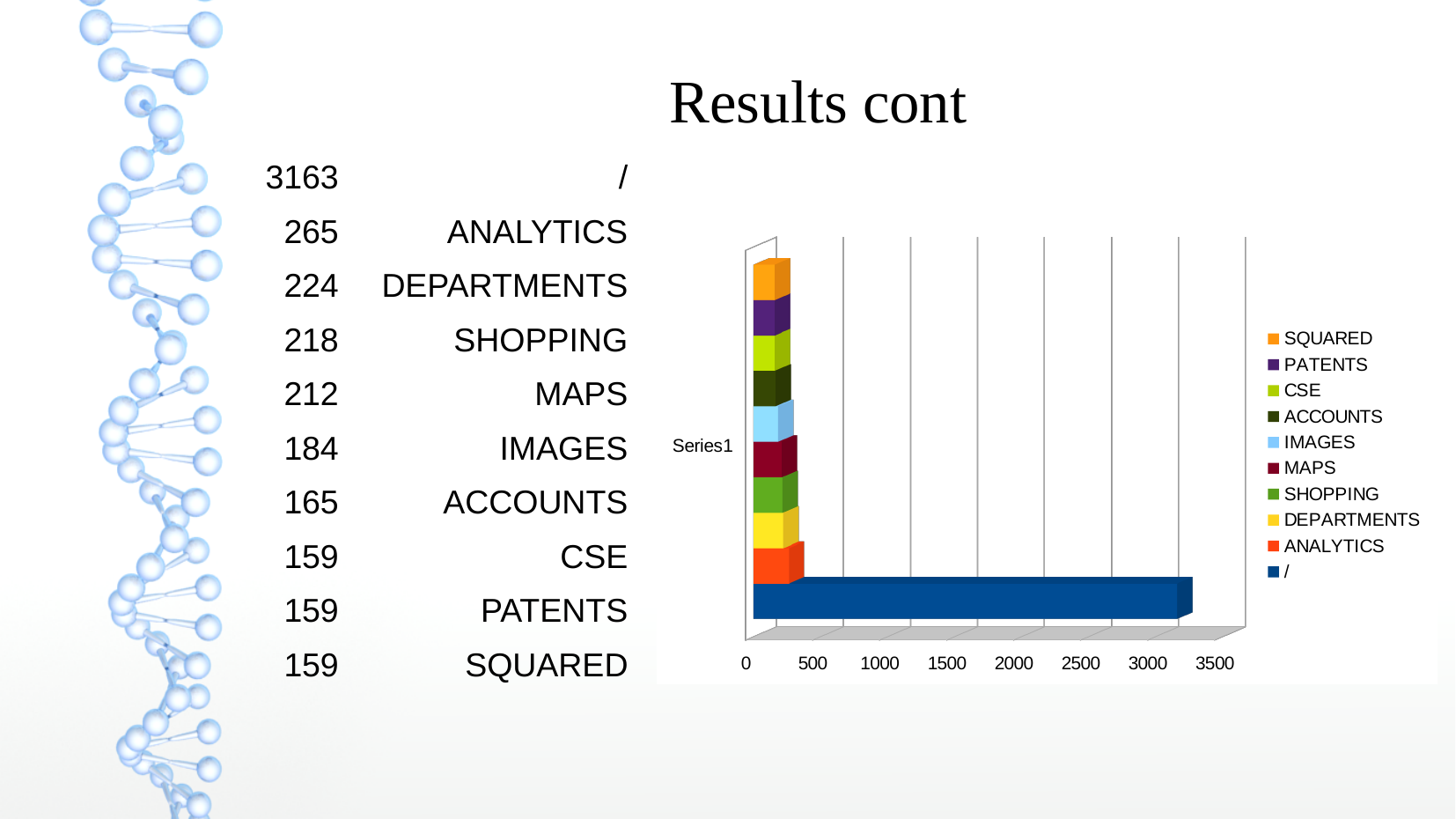
Is the value for the ANALYTICS series greater or less than 500? less According to the values listed on the slide, what is the value for ANALYTICS? 265 What kind of chart is shown on the slide? bar chart What is the category label shown on the vertical axis of the chart? Series1 Is the value for the "/" series greater or less than 3000? greater Which series has the longest bar in the chart? / According to the values listed on the slide, what is the value for the "/" series? 3163 Which is larger, the value for DEPARTMENTS or the value for ACCOUNTS? DEPARTMENTS Using the values listed on the slide, what is the difference between the "/" value and the ANALYTICS value? 2898 According to the values listed on the slide, what is the value for IMAGES? 184 What is the highest tick value shown on the horizontal axis? 3500 How many series does the chart legend list? 10